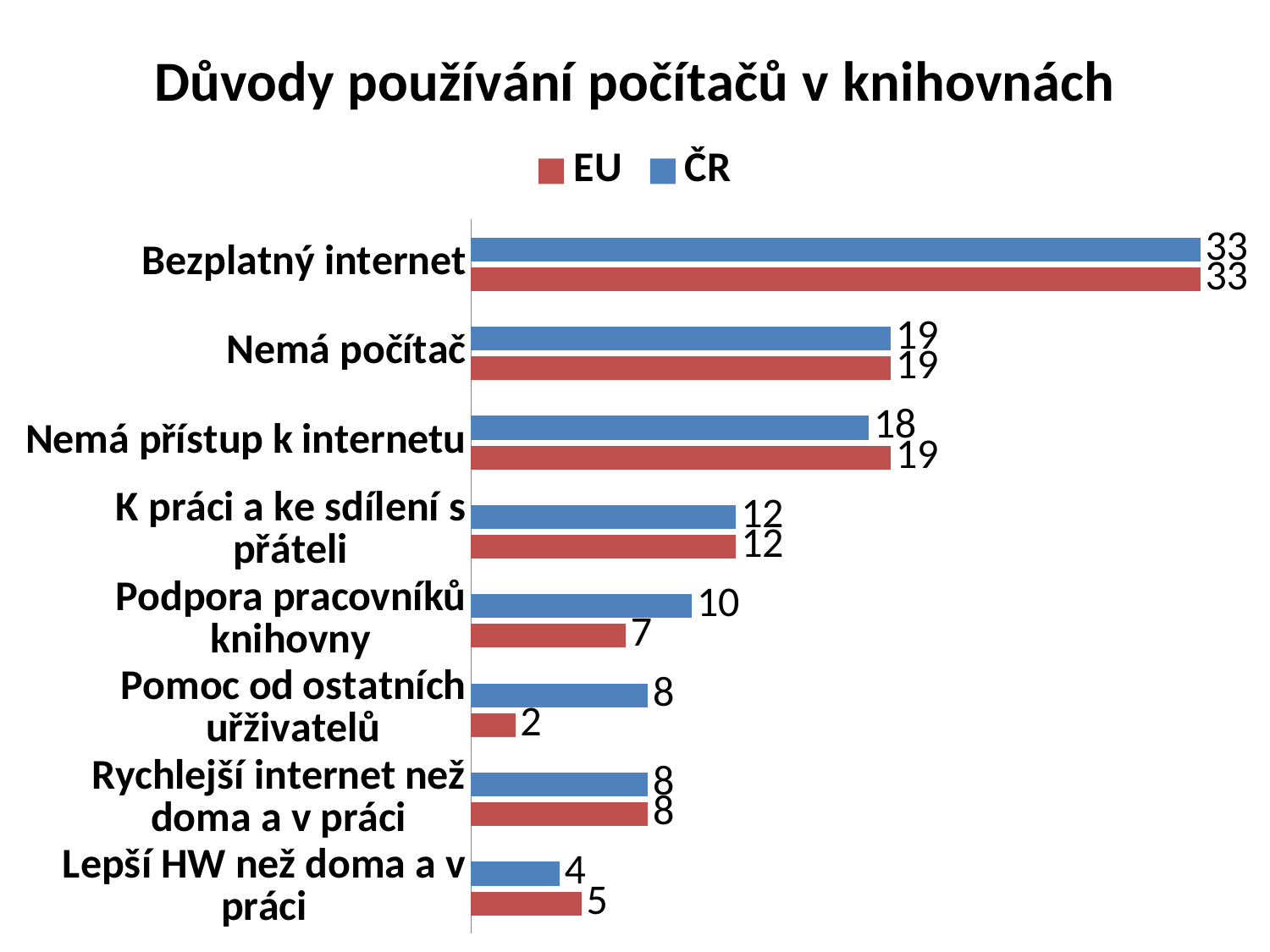
What is the title of the chart? Důvody používání počítačů v knihovnách What is the difference between the ČR and EU values for "Pomoc od ostatních uřživatelů"? 6 What is the EU value for "Podpora pracovníků knihovny"? 7 Which category has the lowest EU value? Pomoc od ostatních uřživatelů What is the EU value for "Pomoc od ostatních uřživatelů"? 2 For "Nemá přístup k internetu", which is larger, the EU value or the ČR value? EU What kind of chart is this? Bar chart What is the ČR value for "Lepší HW než doma a v práci"? 4 Which category has the highest ČR value? Bezplatný internet How many series does the legend list? 2 How many categories are shown on the chart? 8 What is the ČR value for "Bezplatný internet"? 33